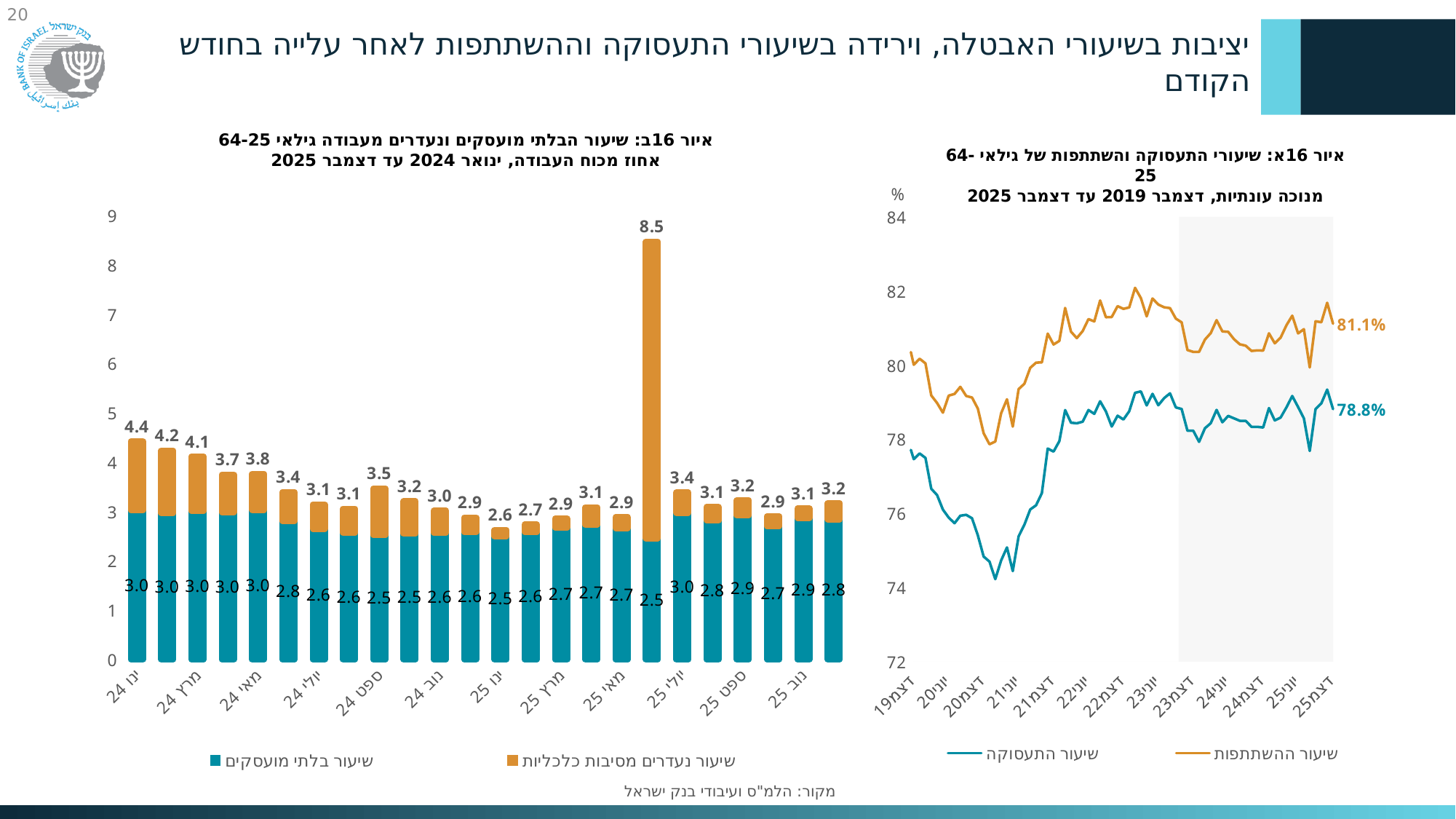
In the left chart (איור 16ב), what is the value of the שיעור נעדרים מסיבות כלכליות segment for ינו 24, given the total 4.4 and the blue segment 3.0? 1.4 In the left chart (איור 16ב), which bar has a larger total: מרץ 24 or מרץ 25? מרץ 24 In the left chart (איור 16ב), what is the highest total value labeled on any bar? 8.5 In the right chart (איור 16א), what is the final labeled value of the שיעור ההשתתפות line? 81.1% In the left chart (איור 16ב), how many series does the legend list? 2 What kind of chart is the left chart (איור 16ב)? Stacked bar chart In the right chart (איור 16א), what is the difference between the final labeled values of the two lines? 2.3 In the left chart (איור 16ב), what is the total value of the bar for ינו 24? 4.4 In the right chart (איור 16א), is the value of the שיעור התעסוקה line at ינו 21 greater or less than 76? less In the right chart (איור 16א), what is the final labeled value of the שיעור התעסוקה line? 78.8% In the left chart (איור 16ב), what is the difference between the total for ינו 24 and the total for ינו 25? 1.8 In the left chart (איור 16ב), what is the value of the שיעור בלתי מועסקים segment for יולי 25? 3.0